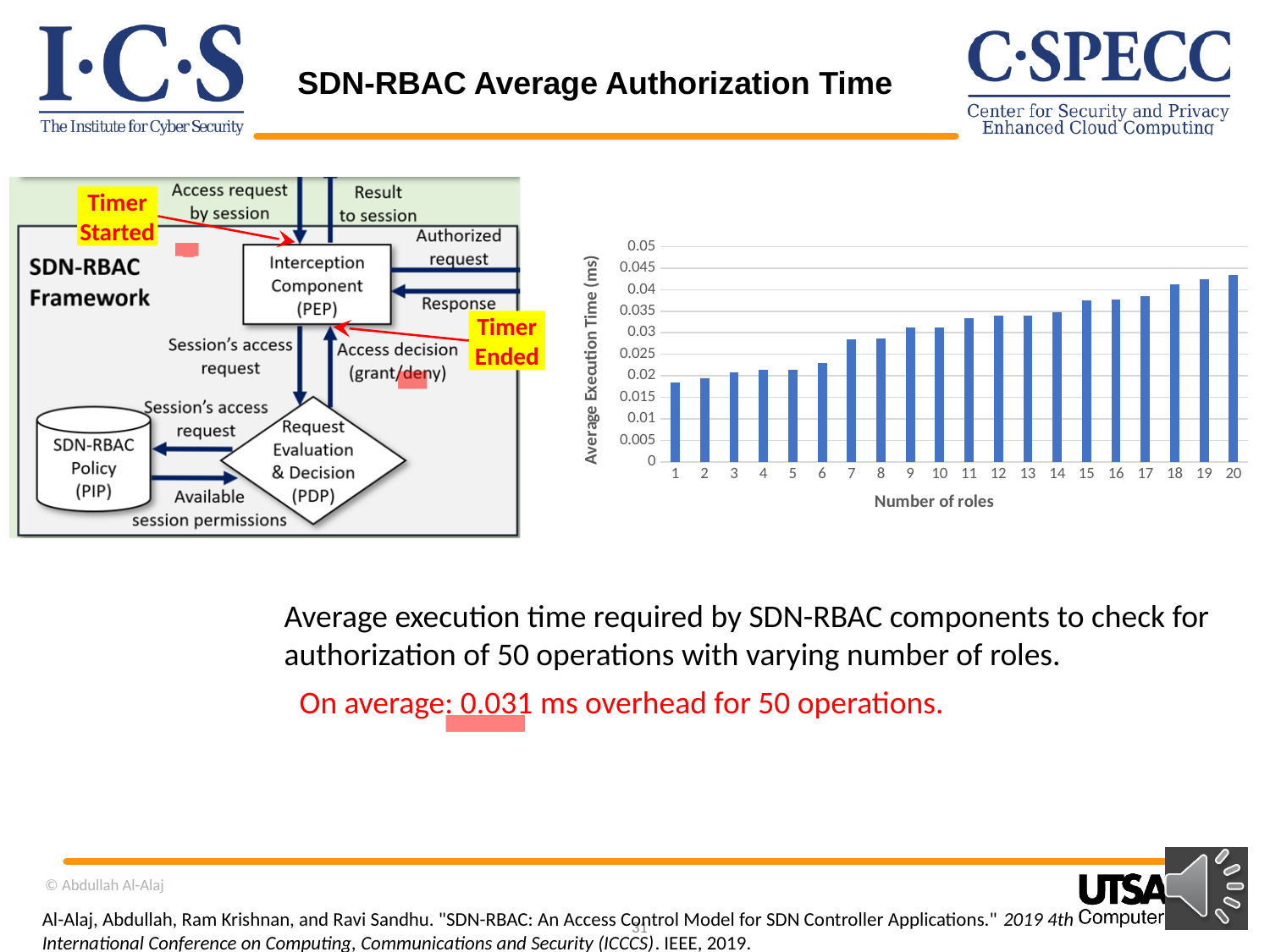
How many categories (number of roles) are plotted on the x axis of the chart? 20 Is the average execution time for 20 roles greater or less than 0.04? greater Which has the higher average execution time, 7 roles or 3 roles? 7 roles Do the average execution times generally rise or fall as the number of roles increases from 1 to 20? rise What kind of chart is shown on the slide? bar chart Is the average execution time for 12 roles greater or less than 0.035? less What is the title of the x axis of the chart? Number of roles Which has the higher average execution time, 10 roles or 18 roles? 18 roles Is the average execution time for 7 roles greater or less than 0.025? greater Which number of roles has the lowest average execution time in the chart? 1 What is the title of the y axis of the chart? Average Execution Time (ms)